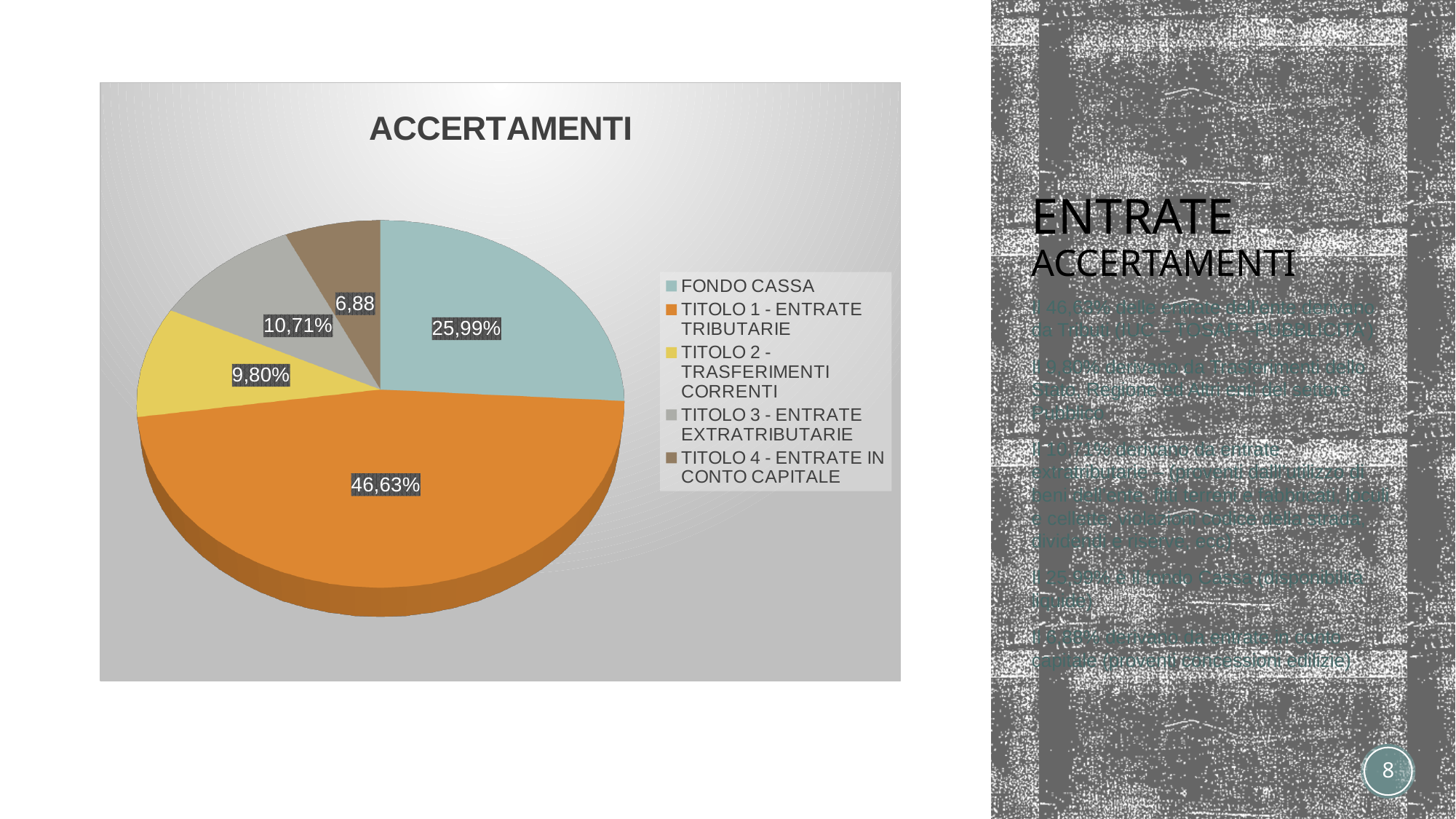
What type of chart is shown on the slide? pie chart What is the value shown for TITOLO 2 - TRASFERIMENTI CORRENTI? 9,80% Which category has the smallest slice of the pie? TITOLO 4 - ENTRATE IN CONTO CAPITALE What is the data label shown for TITOLO 4 - ENTRATE IN CONTO CAPITALE? 6,88 What is the title of the chart? ACCERTAMENTI What is the difference between the values for TITOLO 1 - ENTRATE TRIBUTARIE and FONDO CASSA? 20,64% Which category has the largest slice of the pie? TITOLO 1 - ENTRATE TRIBUTARIE What share of the pie does TITOLO 1 - ENTRATE TRIBUTARIE represent? 46,63% Which is larger, the value for FONDO CASSA or the value for TITOLO 3 - ENTRATE EXTRATRIBUTARIE? FONDO CASSA What is the value shown for FONDO CASSA? 25,99% What is the value shown for TITOLO 3 - ENTRATE EXTRATRIBUTARIE? 10,71% How many slices does the pie chart have? 5